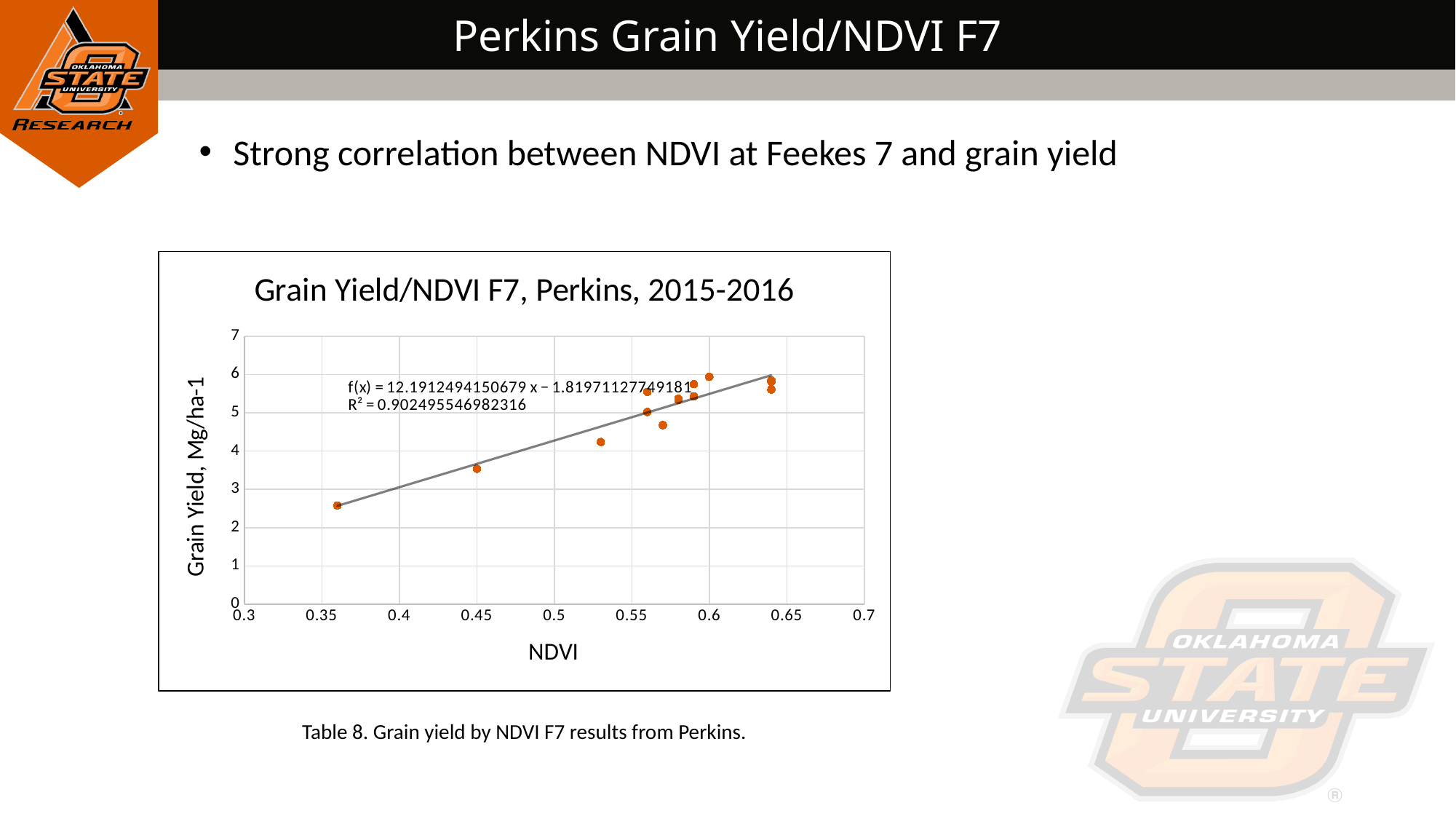
Is the grain yield for the point at NDVI 0.36 greater or less than 2? greater What kind of chart is shown on the slide? Scatter chart Which plotted point has the lowest grain yield? The point at NDVI 0.36 What R² value is printed on the chart for the trendline? 0.902495546982316 Is the grain yield for the point at NDVI 0.36 greater or less than 3? less Is the grain yield for the point at NDVI 0.53 greater or less than 4? greater Which has the lower grain yield: the point at NDVI 0.45 or the point at NDVI 0.53? The point at NDVI 0.45 What is the title of the chart? Grain Yield/NDVI F7, Perkins, 2015-2016 As NDVI increases along the x axis, does grain yield generally rise or fall? Rise Which has the higher grain yield: the point at NDVI 0.36 or the point at NDVI 0.6? The point at NDVI 0.6